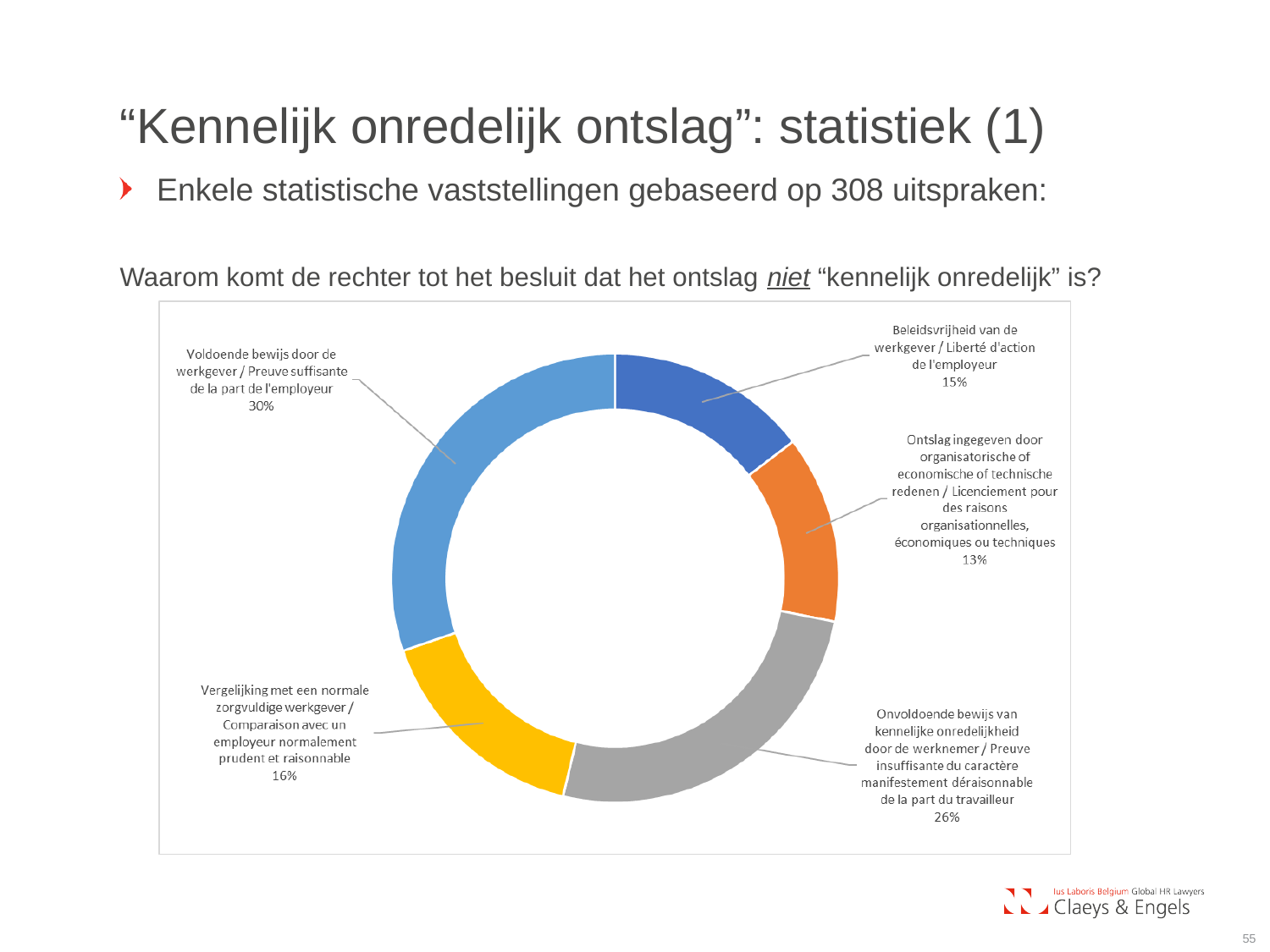
What percentage is shown for "Onvoldoende bewijs van kennelijke onredelijkheid door de werknemer"? 26% Which is larger: the share for "Vergelijking met een normale zorgvuldige werkgever" or the share for "Beleidsvrijheid van de werkgever"? Vergelijking met een normale zorgvuldige werkgever What is the value shown for "Beleidsvrijheid van de werkgever / Liberté d'action de l'employeur"? 15% What colour is the segment for "Onvoldoende bewijs van kennelijke onredelijkheid door de werknemer"? Grey Which category has the largest share of the chart? Voldoende bewijs door de werkgever / Preuve suffisante de la part de l'employeur What share of the chart does "Voldoende bewijs door de werkgever / Preuve suffisante de la part de l'employeur" represent? 30% What kind of chart is shown on the slide? Doughnut (pie) chart Which category has the smallest share of the chart? Ontslag ingegeven door organisatorische of economische of technische redenen / Licenciement pour des raisons organisationnelles, économiques ou techniques What percentage is shown for "Vergelijking met een normale zorgvuldige werkgever"? 16% What is the difference in percentage points between "Voldoende bewijs door de werkgever" and "Onvoldoende bewijs van kennelijke onredelijkheid door de werknemer"? 4 percentage points How many categories are shown in the chart? 5 What percentage is shown for "Ontslag ingegeven door organisatorische of economische of technische redenen"? 13%